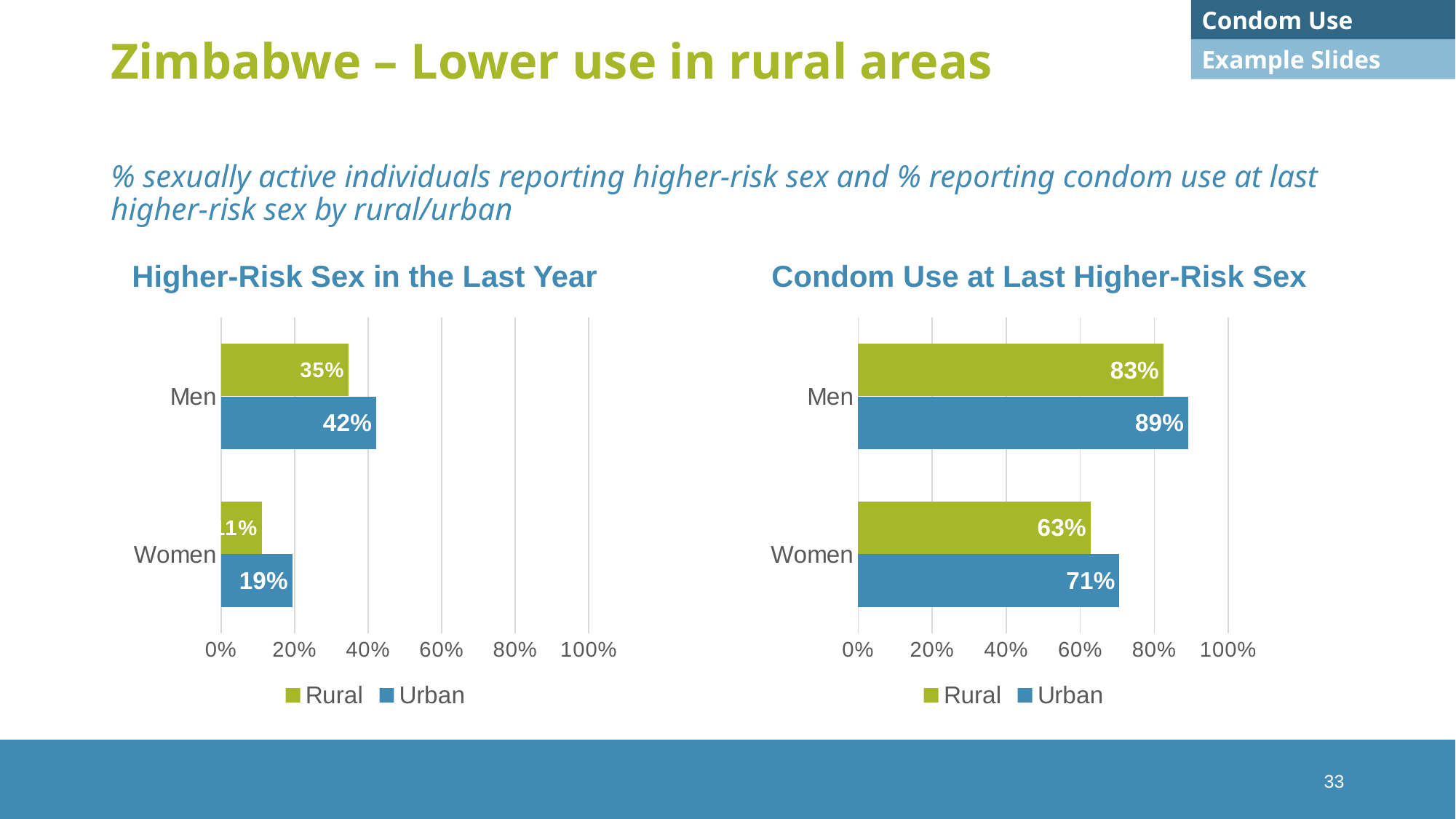
In the 'Condom Use at Last Higher-Risk Sex' chart, what is the value for Rural Women? 63% In the 'Higher-Risk Sex in the Last Year' chart, what is the difference between Urban Men and Rural Men? 7% In the 'Condom Use at Last Higher-Risk Sex' chart, what is the value for Urban Men? 89% What type of chart is the 'Higher-Risk Sex in the Last Year' chart? Bar chart In the 'Condom Use at Last Higher-Risk Sex' chart, is the value for Rural Men or Rural Women larger? Rural Men In the 'Higher-Risk Sex in the Last Year' chart, which bar is the lowest? Rural Women In the 'Higher-Risk Sex in the Last Year' chart, what is the value for Rural Men? 35% In the 'Higher-Risk Sex in the Last Year' chart, is the value for Rural Women greater or less than 20%? less In the 'Condom Use at Last Higher-Risk Sex' chart, what is the difference between Urban Women and Rural Women? 8% How many series does the legend of the 'Condom Use at Last Higher-Risk Sex' chart list? 2 In the 'Condom Use at Last Higher-Risk Sex' chart, which bar is the highest? Urban Men In the 'Higher-Risk Sex in the Last Year' chart, what is the value for Urban Men? 42%